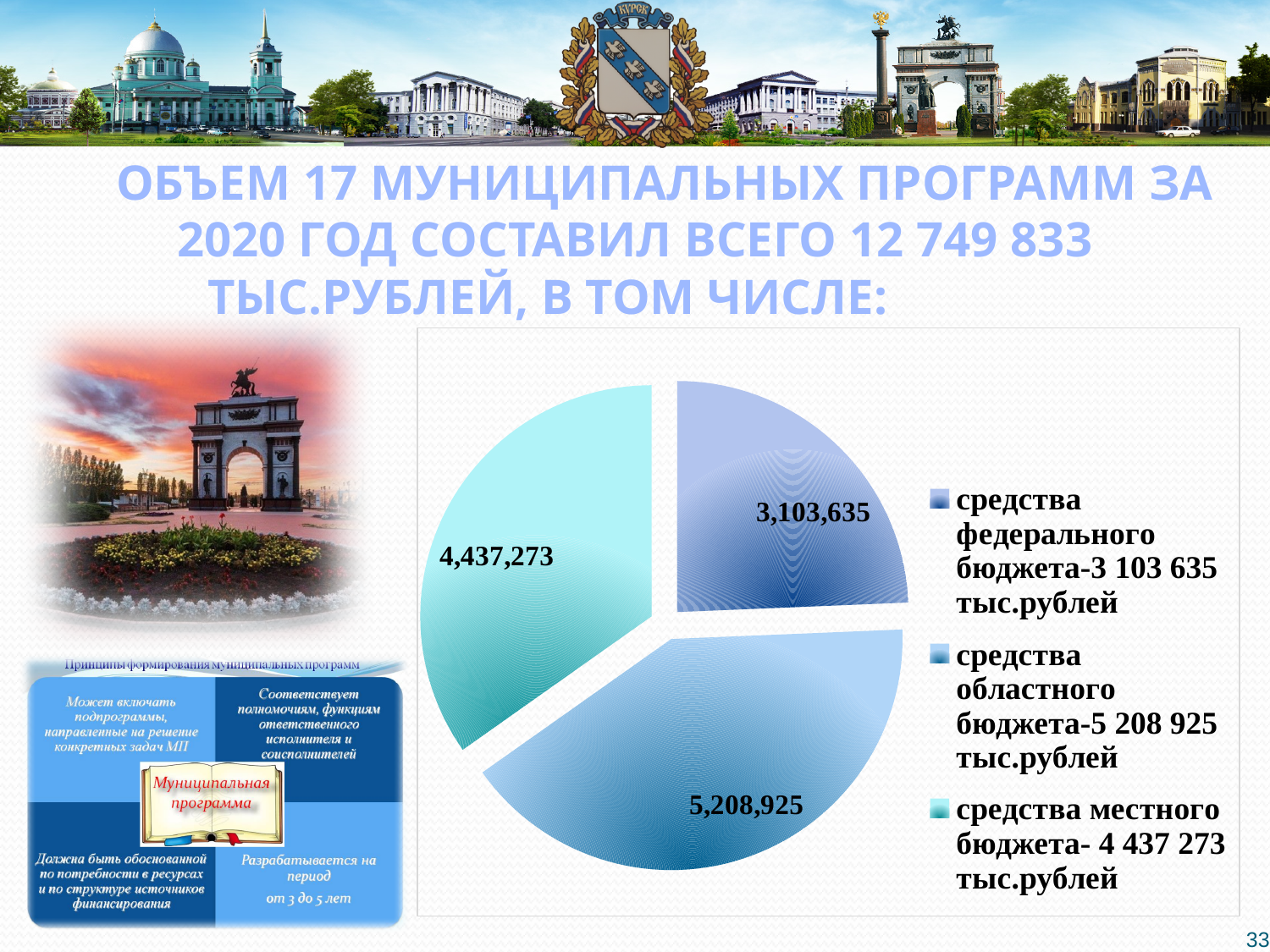
What is the value shown for средства местного бюджета? 4,437,273 What is the difference between the regional budget (областного бюджета) value and the local budget (местного бюджета) value? 771,652 How many slices does the pie chart have? 3 What kind of chart is shown on the slide? Pie chart What is the difference between the regional budget (областного бюджета) value and the federal budget (федерального бюджета) value? 2,105,290 What is the value shown for средства областного бюджета? 5,208,925 Which budget source has the largest slice of the pie chart? средства областного бюджета What is the total of the three slices in the pie chart? 12,749,833 Which is larger: the value for средства местного бюджета or the value for средства федерального бюджета? средства местного бюджета Which budget source has the smallest slice of the pie chart? средства федерального бюджета What is the value shown for средства федерального бюджета? 3,103,635 How many entries does the legend of the pie chart list? 3